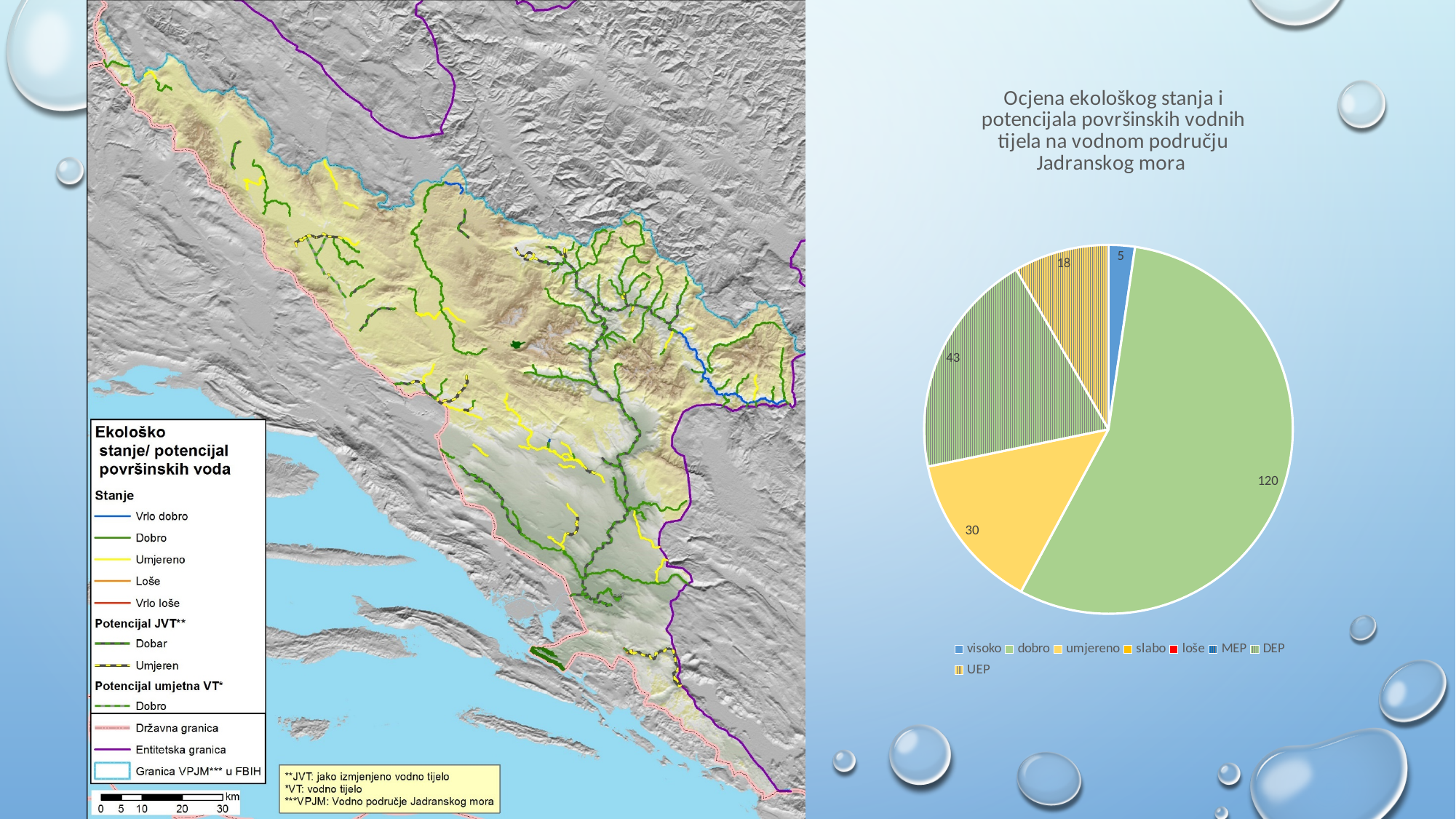
In the pie chart, what is the value for 'visoko'? 5 In the pie chart, what is the value for 'UEP'? 18 In the pie chart, which is larger: 'DEP' or 'UEP'? DEP Which labelled slice in the pie chart has the smallest value? visoko In the pie chart, what is the value for 'dobro'? 120 How many entries does the legend of the pie chart list? 8 In the pie chart, what is the value for 'DEP'? 43 What is the title of the pie chart? Ocjena ekološkog stanja i potencijala površinskih vodnih tijela na vodnom području Jadranskog mora What kind of chart is shown on the right side of the slide? pie chart In the pie chart, what is the difference between the values for 'DEP' and 'UEP'? 25 In the pie chart, what is the difference between the values for 'dobro' and 'DEP'? 77 Which category has the largest slice in the pie chart? dobro